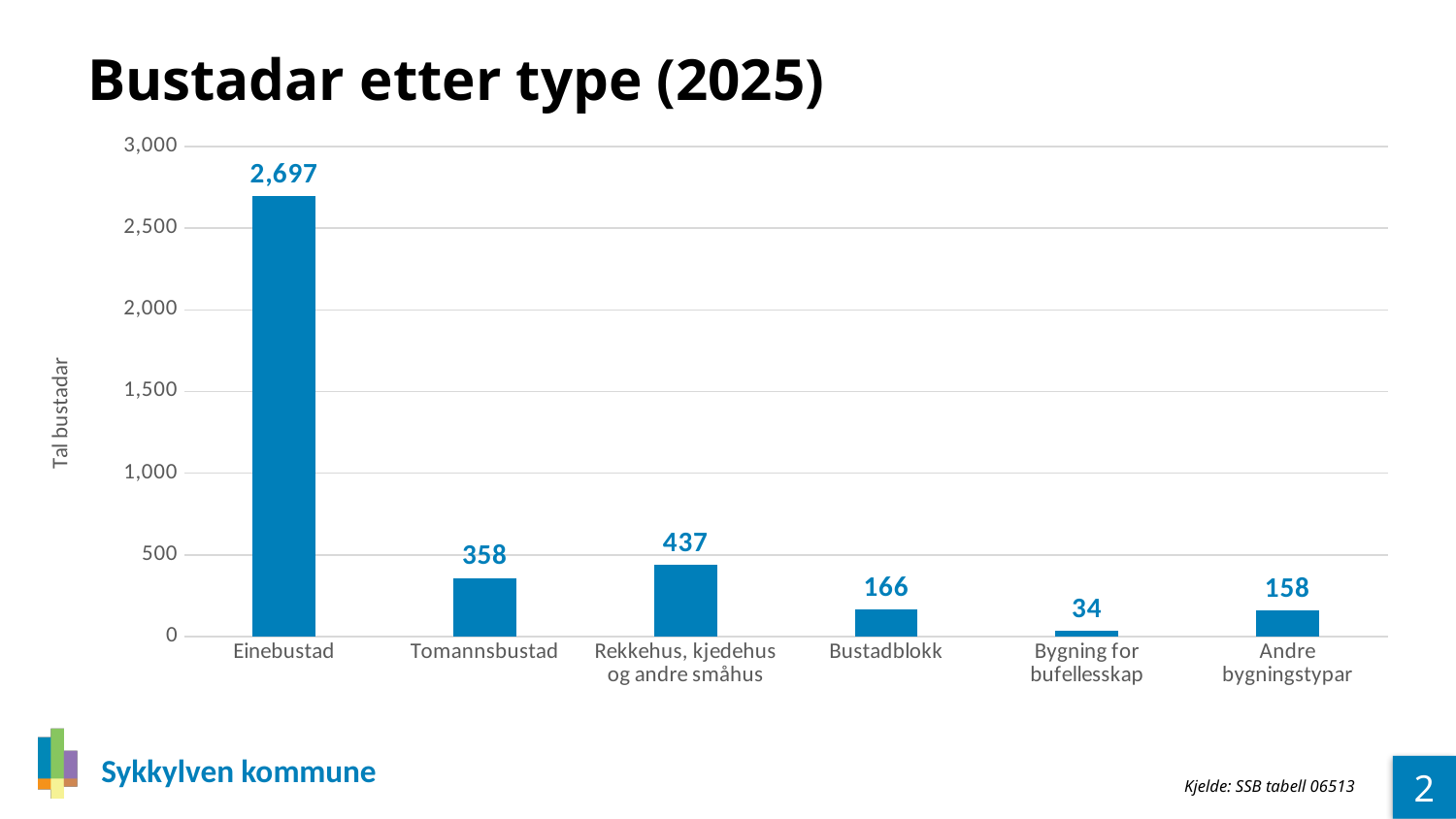
Is the value for Einebustad greater or less than 2,500? greater How many categories are shown on the x axis? 6 Which is larger, the value for Bustadblokk or the value for Andre bygningstypar? Bustadblokk What is the value for Andre bygningstypar? 158 What is the difference between the values for Rekkehus, kjedehus og andre småhus and Tomannsbustad? 79 What kind of chart is this? bar chart What is the value for Einebustad? 2,697 Which category has the lowest value? Bygning for bufellesskap What is the title of the chart? Bustadar etter type (2025) What is the value for Bygning for bufellesskap? 34 What is the value for Tomannsbustad? 358 Which category has the highest value? Einebustad